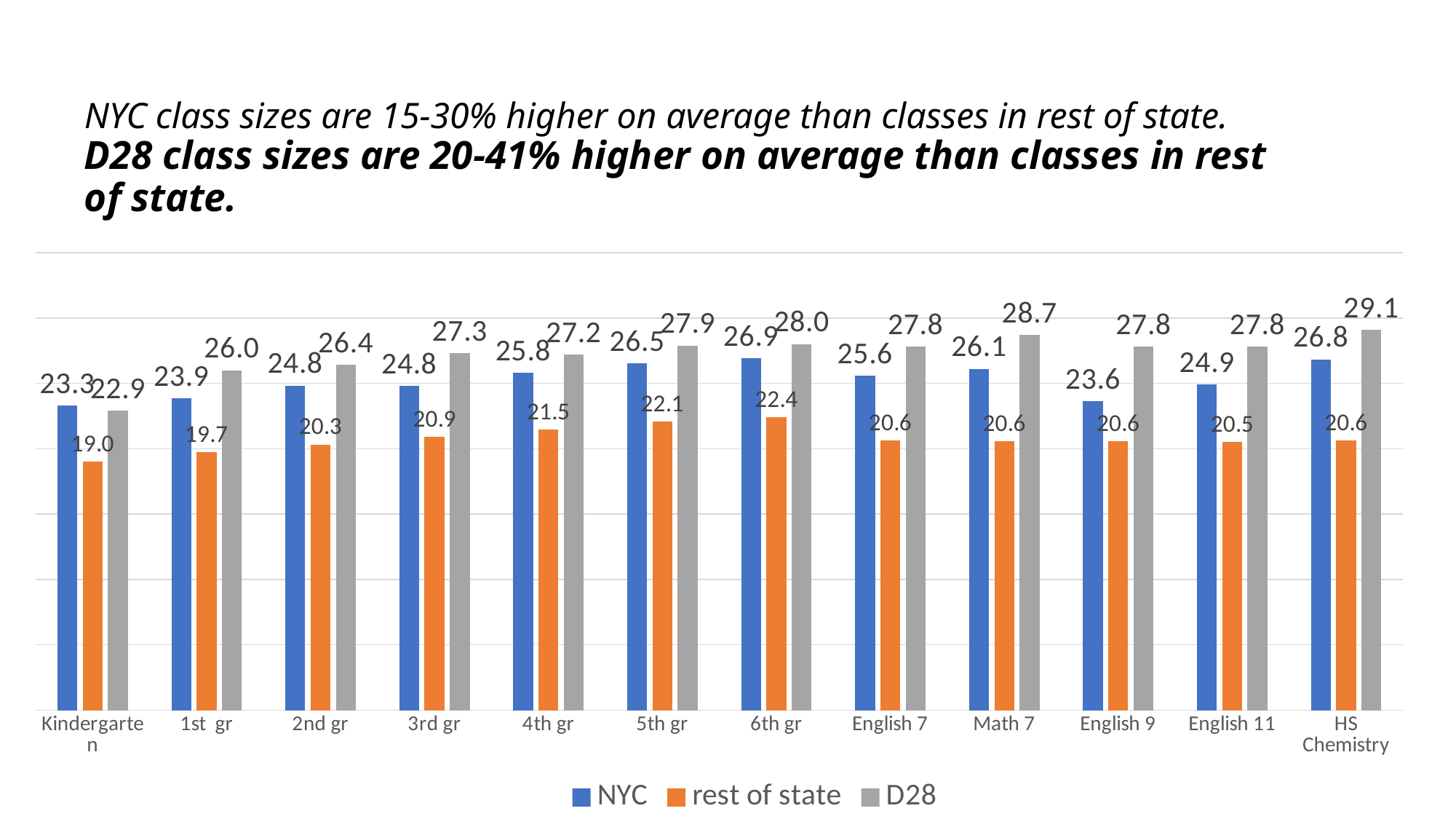
How many series does the legend list? 3 Which category has the highest D28 value? HS Chemistry How many categories are shown on the x axis? 12 Does the rest of state value rise or fall from Kindergarten to 6th gr? rise What type of chart is shown on the slide? bar chart What is the difference between the D28 and rest of state values for Math 7? 8.1 What is the NYC value for Math 7? 26.1 What is the rest of state value for 5th gr? 22.1 Which series is shown in orange in the legend? rest of state Which category has the lowest rest of state value? Kindergarten Which is larger for Kindergarten, the NYC value or the D28 value? NYC What is the D28 value for HS Chemistry? 29.1